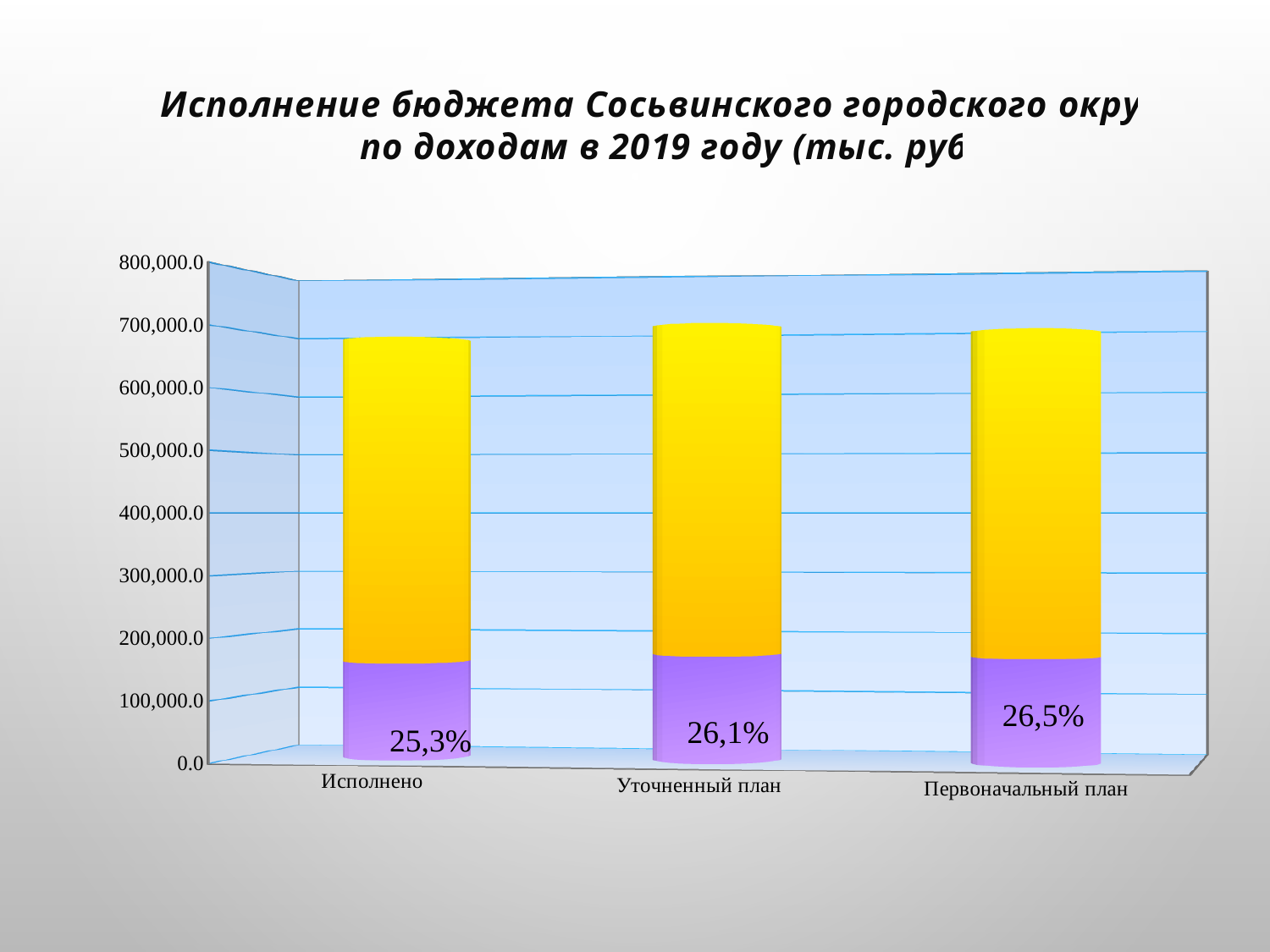
Is the total height of the Исполнено bar greater or less than 600,000.0? greater What kind of chart is shown on the slide? bar chart What is the difference between the percentage labels on the Первоначальный план bar and the Исполнено bar? 1,2% Which percentage label is larger: the one on the Уточненный план bar or the one on the Исполнено bar? Уточненный план Which bar has the lowest percentage label printed on it? Исполнено Which bar has the highest percentage label printed on it? Первоначальный план What percentage label is printed on the Исполнено bar? 25,3% How many categories are shown on the x axis of the chart? 3 Is the purple segment of the Уточненный план bar greater or less than 200,000.0? less What percentage label is printed on the Уточненный план bar? 26,1% What percentage label is printed on the Первоначальный план bar? 26,5% What year does the chart title say the budget execution refers to? 2019